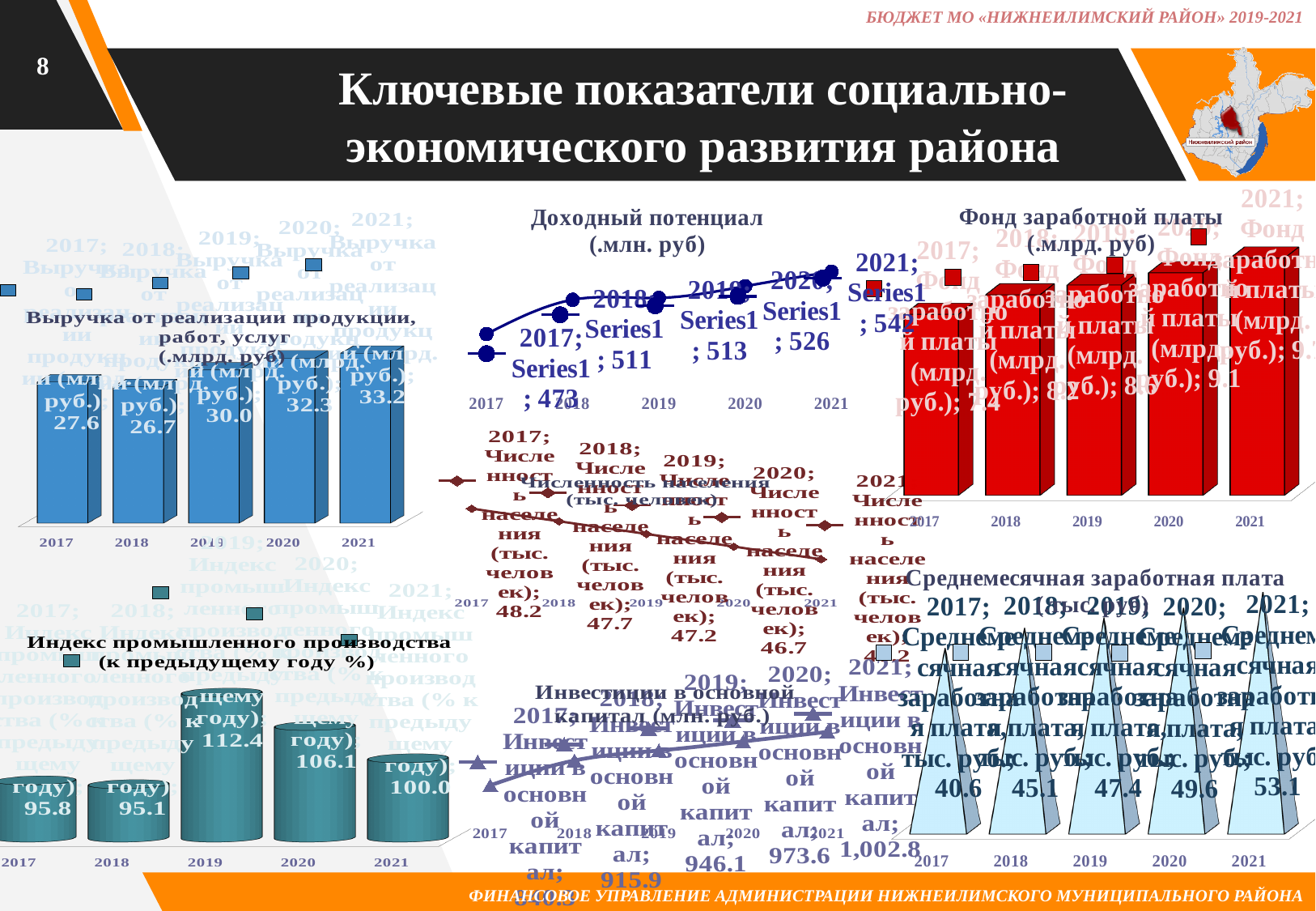
What kind of chart is 'Доходный потенциал (.млн. руб)'? line chart In the chart 'Выручка от реализации продукции, работ, услуг (.млрд. руб)', which year has the lowest value? 2018 In the chart 'Доходный потенциал (.млн. руб)', what is the value for 2017? 473 In the chart 'Доходный потенциал (.млн. руб)', what is the difference between the 2021 and 2017 values? 69 In the chart 'Численность населения (тыс. человек)', what is the value for 2019? 47.2 In the chart 'Численность населения (тыс. человек)', do the values rise or fall from 2017 to 2021? fall In the chart 'Выручка от реализации продукции, работ, услуг (.млрд. руб)', what is the value for 2021? 33.2 In the chart 'Индекс промышленного производства (к предыдущему году %)', which year has the highest value? 2019 In the chart 'Индекс промышленного производства (к предыдущему году %)', what is the value for 2020? 106.1 In the chart 'Инвестиции в основной капитал (млн. руб.)', what is the value for 2021? 1,002.8 In the chart 'Среднемесячная заработная плата, тыс. руб.', what is the value for 2018? 45.1 In the chart 'Среднемесячная заработная плата, тыс. руб.', how many years are shown? 5